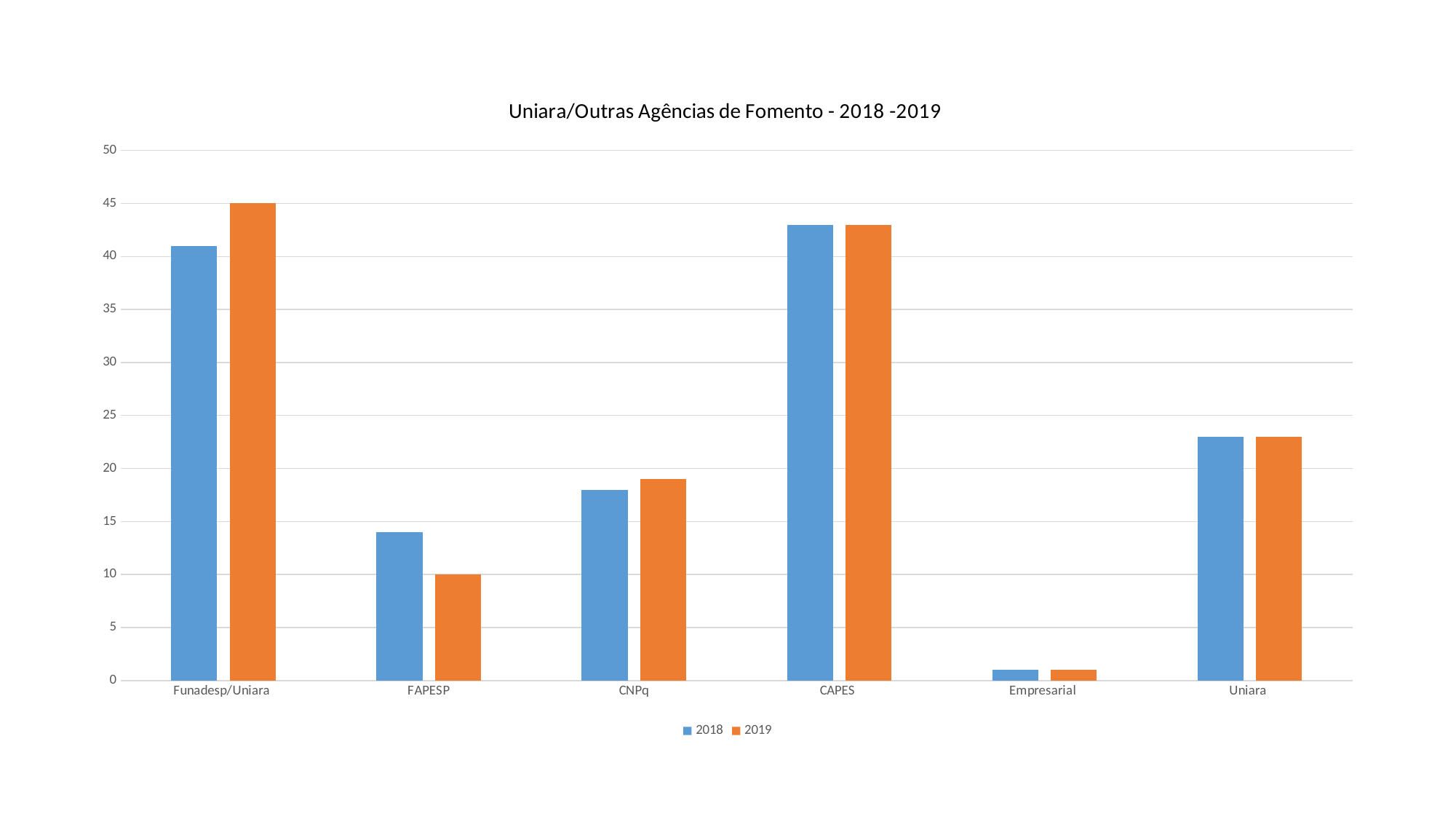
What is the value for Funadesp/Uniara in 2019? 45 Is the value for CNPq in 2019 greater or less than 20? less For FAPESP, which year has the larger value, 2018 or 2019? 2018 Which category has the highest value for 2019? Funadesp/Uniara For Funadesp/Uniara, which year has the larger value, 2018 or 2019? 2019 Is the value for Uniara in 2018 greater or less than 20? greater Is the value for CAPES in 2018 greater or less than 40? greater How many series does the legend list? 2 What type of chart is shown on the slide? Bar chart Which category has the lowest value for 2018? Empresarial How many categories are shown on the x axis? 6 What is the value for FAPESP in 2019? 10